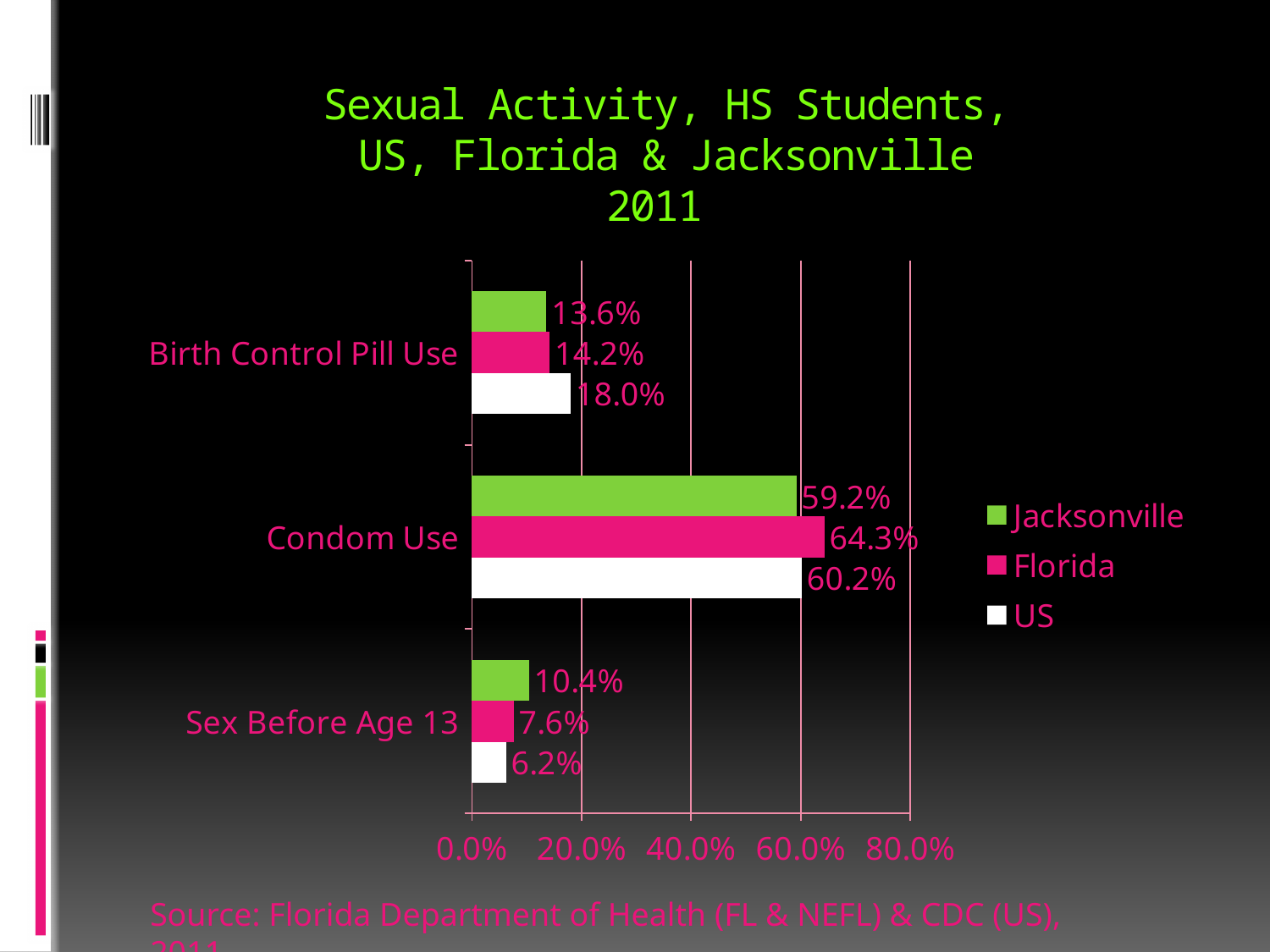
What is the Florida value for Sex Before Age 13? 7.6% What is the US value for Birth Control Pill Use? 18.0% What is the difference between the Florida and Jacksonville values for Condom Use? 5.1% What is the Jacksonville value for Condom Use? 59.2% Is the Florida value for Condom Use greater or less than 60.0%? greater How many series does the legend list? 3 Which colour represents Florida in the chart? pink How many categories are shown on the chart? 3 What kind of chart is shown on the slide? bar chart Which series has the lowest value for Sex Before Age 13? US Which is larger for Birth Control Pill Use: the US value or the Jacksonville value? US Which series has the highest value for Condom Use? Florida